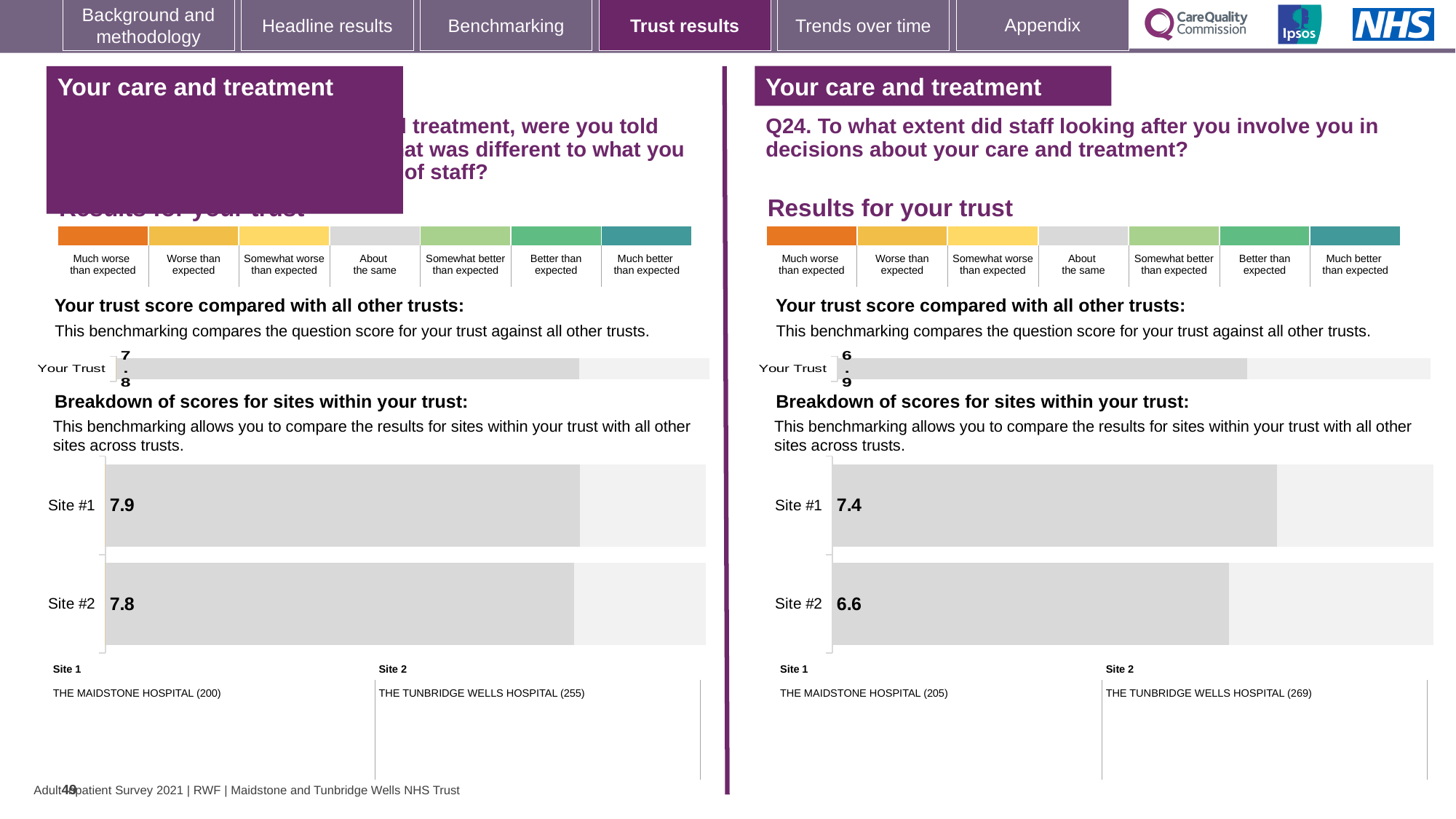
On the right-hand (Q24) site breakdown chart, what is the score for Site #1? 7.4 On the right-hand (Q24) site breakdown chart, which hospital is listed as Site 2? THE TUNBRIDGE WELLS HOSPITAL (269) On the left-hand site breakdown chart, what is the score for Site #2? 7.8 On the left-hand site breakdown chart, what is the score for Site #1? 7.9 On the left-hand site breakdown chart, what is the difference between the Site #1 and Site #2 scores? 0.1 On the right-hand (Q24) site breakdown chart, which site has the higher score? Site #1 How many sites are shown on the right-hand (Q24) site breakdown chart? 2 What kind of chart is the right-hand (Q24) site breakdown chart? Bar chart On the left-hand 'Your trust score compared with all other trusts' chart, what is the score shown for Your Trust? 7.8 On the right-hand (Q24) 'Your trust score compared with all other trusts' chart, what is the score shown for Your Trust? 6.9 On the right-hand (Q24) site breakdown chart, what is the difference between the Site #1 and Site #2 scores? 0.8 On the right-hand (Q24) site breakdown chart, what is the score for Site #2? 6.6